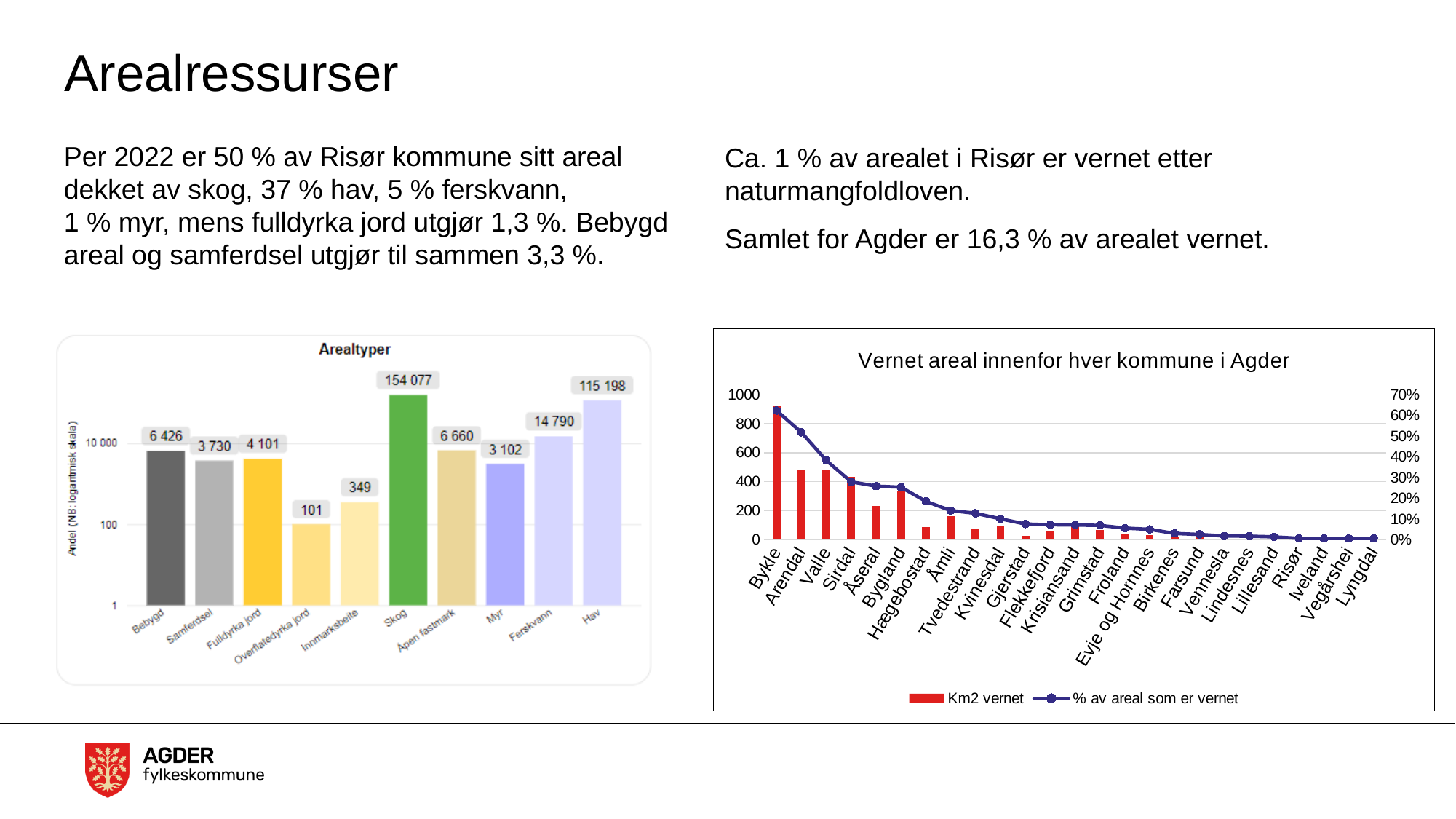
In the Arealtyper chart, what is the value for Overflatedyrka jord? 101 In the Arealtyper chart, which category has the lowest value? Overflatedyrka jord How many categories are shown in the Arealtyper chart? 10 In the Arealtyper chart, what is the value for Skog? 154 077 In the chart titled 'Vernet areal innenfor hver kommune i Agder', is the Km2 vernet value for Bykle greater or less than 800? greater In the chart titled 'Vernet areal innenfor hver kommune i Agder', how many series does the legend list? 2 In the chart titled 'Vernet areal innenfor hver kommune i Agder', does the '% av areal som er vernet' line rise or fall from left to right? Fall What kind of chart is the Arealtyper chart? Bar chart In the Arealtyper chart, what is the difference between the values for Skog and Hav? 38 879 In the Arealtyper chart, which category has the highest value? Skog In the Arealtyper chart, what is the value for Ferskvann? 14 790 In the Arealtyper chart, which is larger, Bebygd or Åpen fastmark? Åpen fastmark